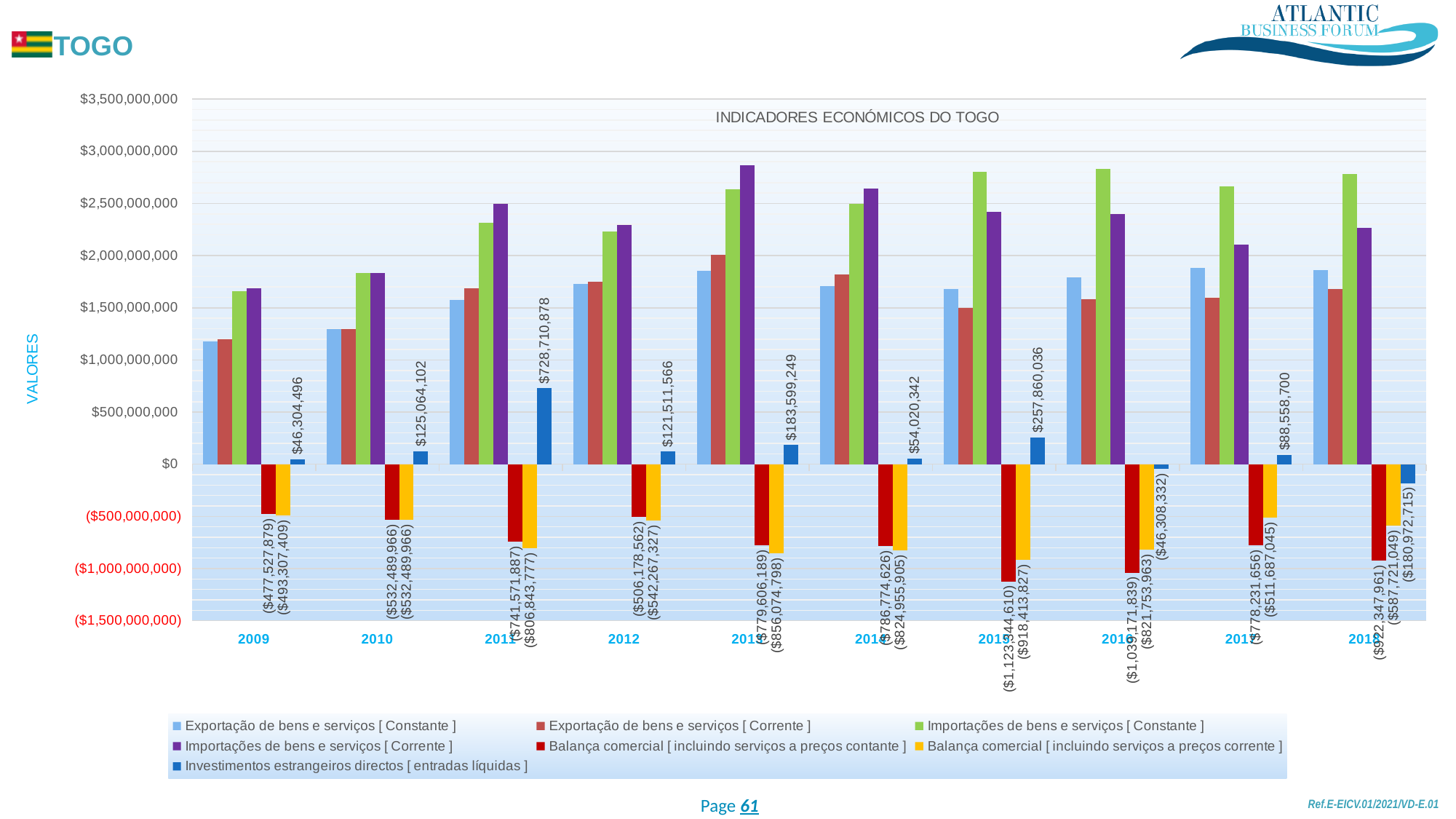
What is the value of Investimentos estrangeiros directos [entradas líquidas] in 2011? $728,710,878 Which year has the larger value for Investimentos estrangeiros directos [entradas líquidas], 2013 or 2014? 2013 In which year is Investimentos estrangeiros directos [entradas líquidas] lowest? 2018 How many series does the legend list? 7 What is the value of Balança comercial [incluindo serviços a preços contante] in 2015? ($1,123,344,610) Is the value for Importações de bens e serviços [Constante] in 2015 greater or less than $2,500,000,000? greater What is the title of the chart? INDICADORES ECONÓMICOS DO TOGO What is the value of Balança comercial [incluindo serviços a preços corrente] in 2017? ($511,687,045) What kind of chart is shown? bar chart How many years are shown on the x axis? 10 What is the difference between Investimentos estrangeiros directos [entradas líquidas] in 2011 and in 2010? $603,646,776 In which year is Investimentos estrangeiros directos [entradas líquidas] highest? 2011